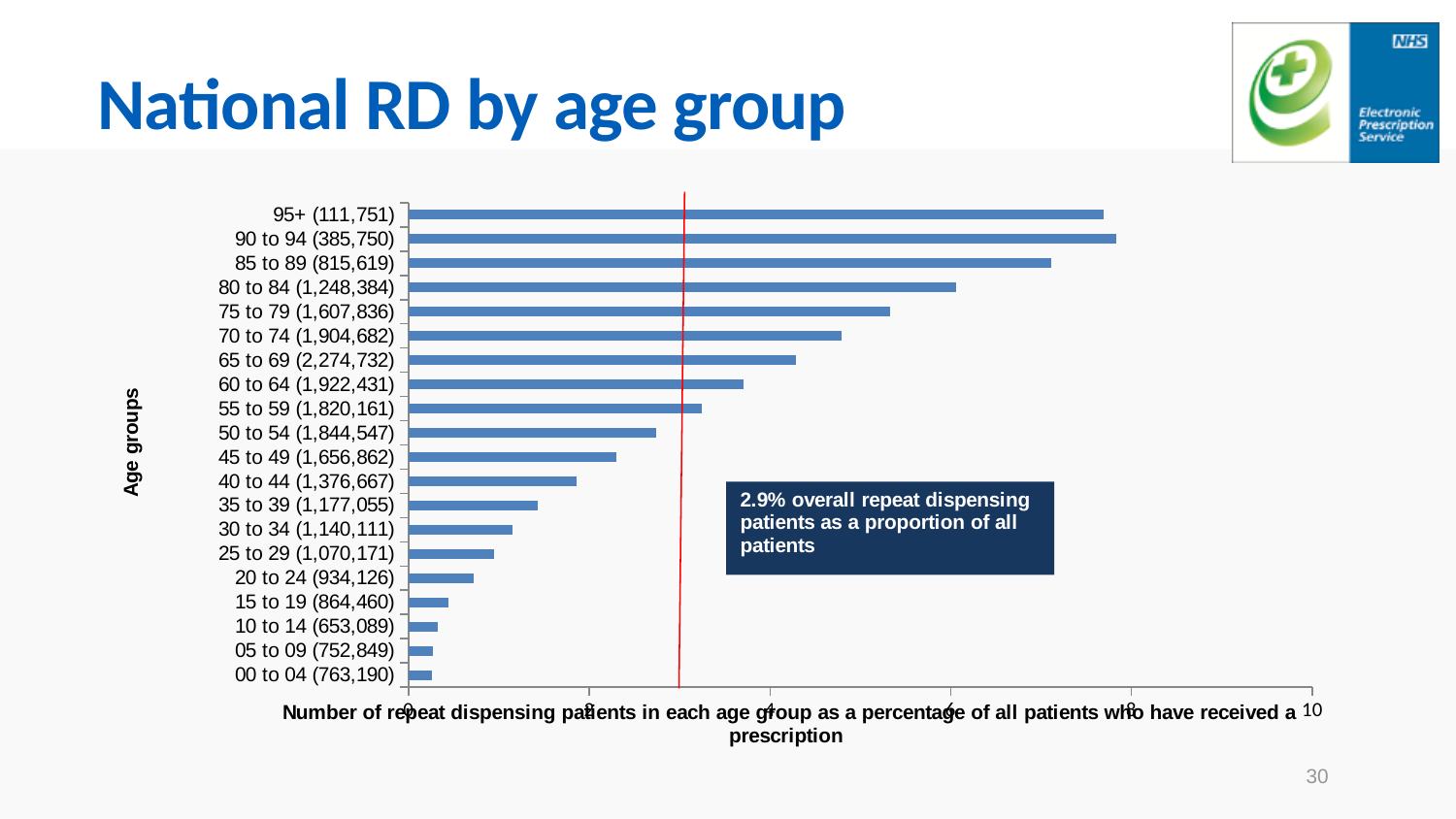
What is the number of patients shown in parentheses for the 95+ age group? 111,751 How many age groups are plotted in the chart? 20 Which has the larger value, the 60 to 64 age group or the 40 to 44 age group? 60 to 64 Is the value for the 75 to 79 age group greater or less than 4? greater What is the number of patients shown in parentheses for the 00 to 04 age group? 763,190 Which has the larger value, the 85 to 89 age group or the 75 to 79 age group? 85 to 89 Is the value for the 85 to 89 age group greater or less than 6? greater What is the number of patients shown in parentheses for the 65 to 69 age group? 2,274,732 What kind of chart is shown on the slide? bar chart Is the value for the 60 to 64 age group greater or less than 4? less What overall percentage of repeat dispensing patients does the red vertical line represent? 2.9%